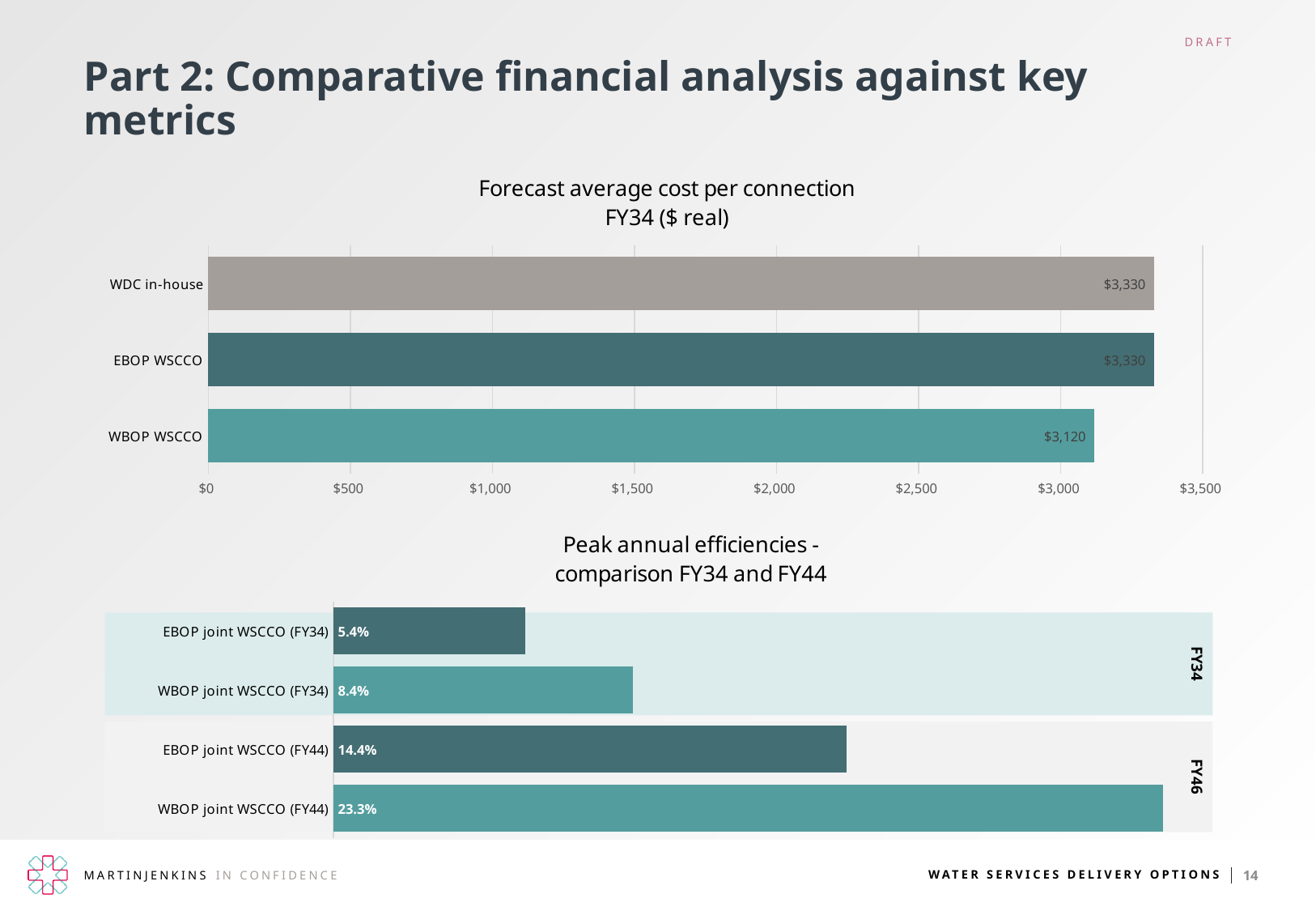
What kind of chart is the 'Forecast average cost per connection FY34 ($ real)' chart? Bar chart In the 'Forecast average cost per connection FY34 ($ real)' chart, which category has the lowest value? WBOP WSCCO In the 'Peak annual efficiencies - comparison FY34 and FY44' chart, what is the value for WBOP joint WSCCO (FY44)? 23.3% In the 'Forecast average cost per connection FY34 ($ real)' chart, what is the value for WBOP WSCCO? $3,120 In the 'Forecast average cost per connection FY34 ($ real)' chart, what is the difference between WDC in-house and WBOP WSCCO? $210 In the 'Peak annual efficiencies - comparison FY34 and FY44' chart, how many bars are shown? 4 In the 'Forecast average cost per connection FY34 ($ real)' chart, how many categories are shown? 3 In the 'Forecast average cost per connection FY34 ($ real)' chart, what is the value for EBOP WSCCO? $3,330 In the 'Peak annual efficiencies - comparison FY34 and FY44' chart, what is the value for EBOP joint WSCCO (FY34)? 5.4% In the 'Peak annual efficiencies - comparison FY34 and FY44' chart, which category has the highest value? WBOP joint WSCCO (FY44) In the 'Peak annual efficiencies - comparison FY34 and FY44' chart, what is the difference between WBOP joint WSCCO (FY44) and EBOP joint WSCCO (FY44)? 8.9% In the 'Peak annual efficiencies - comparison FY34 and FY44' chart, which is larger: WBOP joint WSCCO (FY34) or EBOP joint WSCCO (FY34)? WBOP joint WSCCO (FY34)